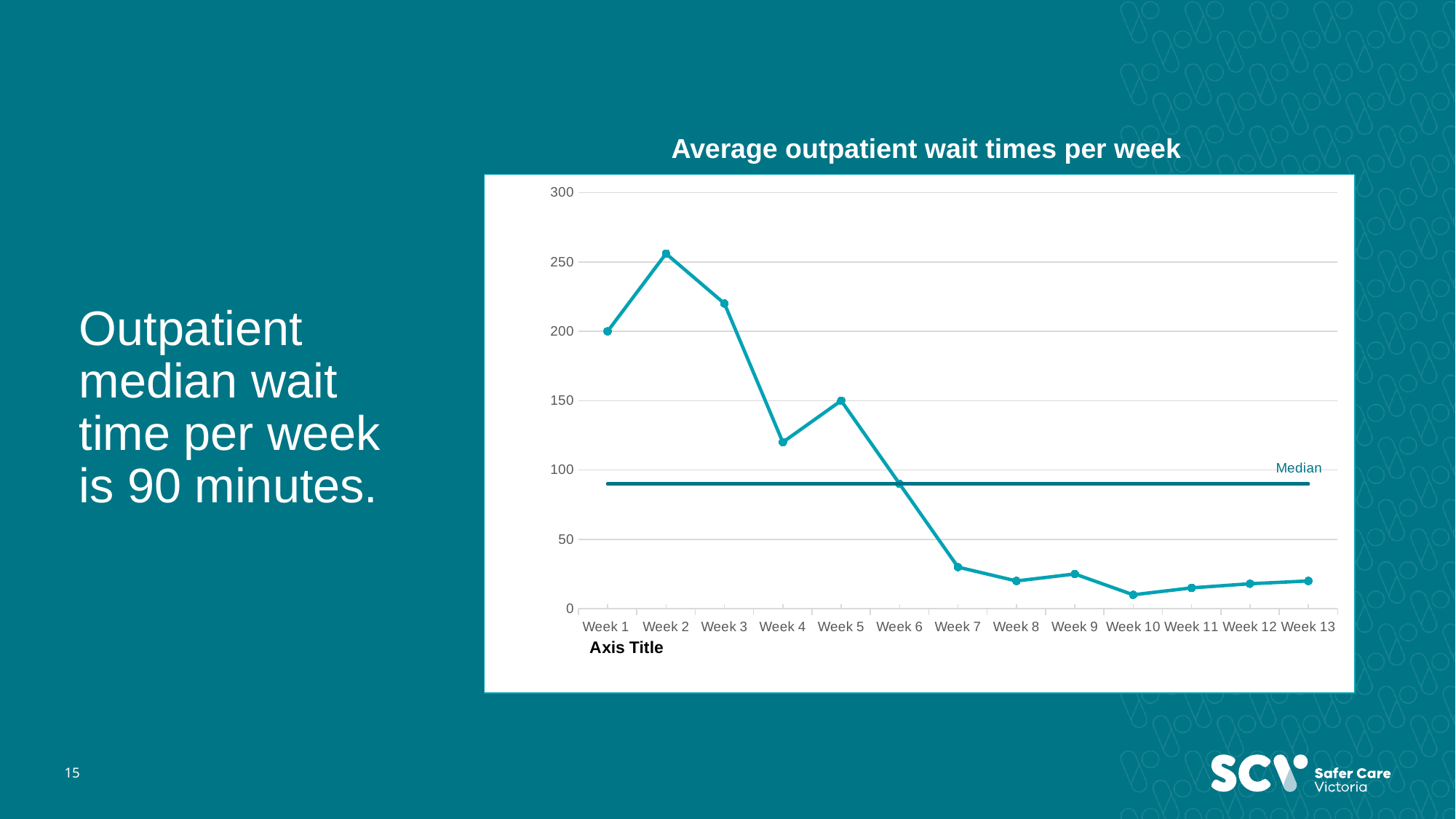
Is the value for Week 4 greater or less than 100? greater Which week has the lowest average wait time? Week 10 Do the average wait times generally rise or fall from Week 2 to Week 10? fall Is the value for Week 2 greater or less than 250? greater How many weeks are plotted along the x axis? 13 What is the title of the chart? Average outpatient wait times per week Is the value for Week 7 greater or less than 50? less What is the average wait time for Week 5? 150 Which is larger, the value for Week 3 or the value for Week 4? Week 3 What kind of chart is shown on the slide? line chart Which week has the highest average wait time? Week 2 What is the average wait time for Week 1? 200